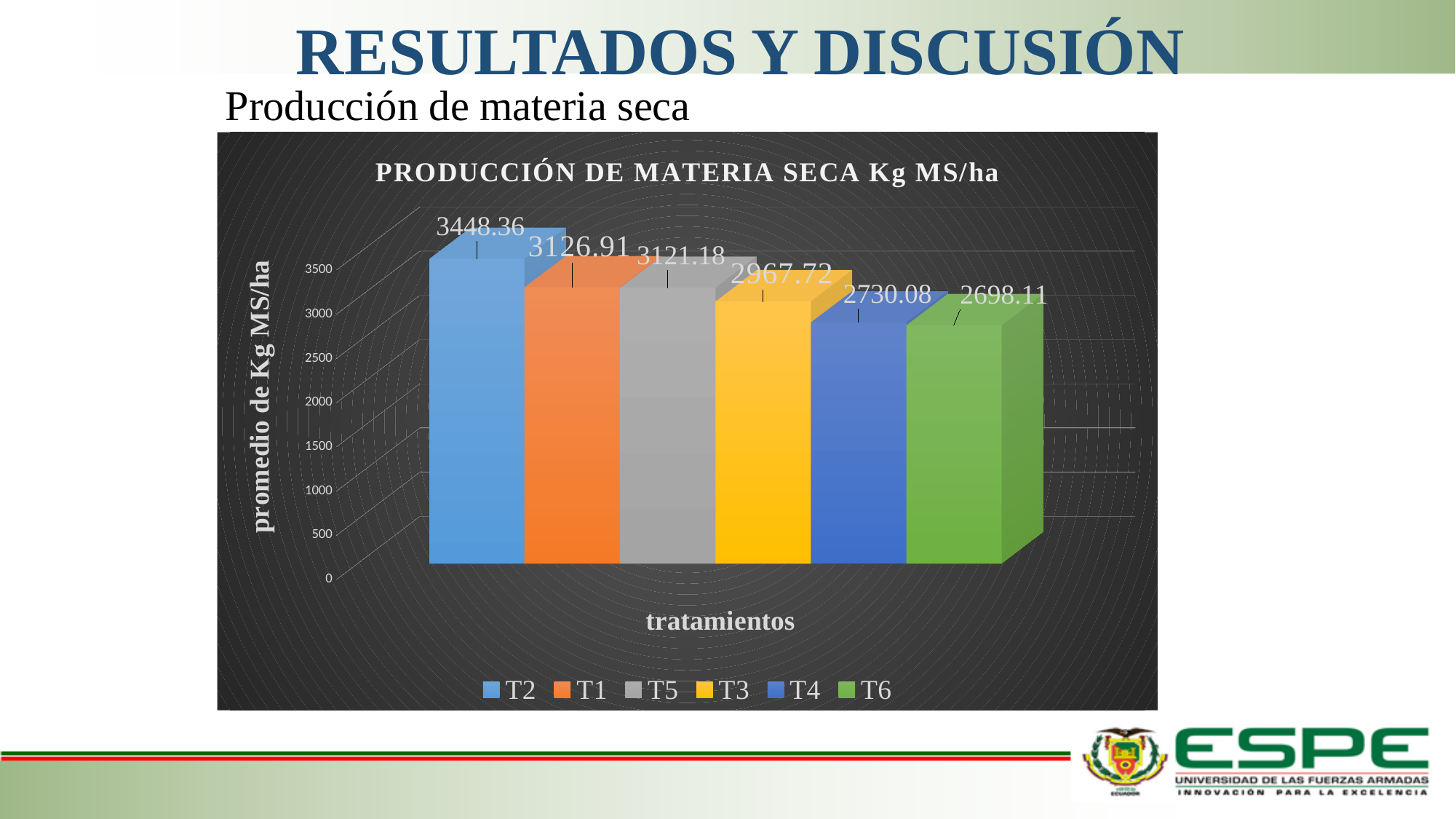
Which treatment has the highest production of dry matter? T2 What is the value for T4 in the chart? 2730.08 What type of chart is shown on the slide? bar chart How many bars are shown in the chart? 6 Which treatment has the lowest production of dry matter? T6 What is the difference between the values for T3 and T4? 237.64 What is the value for T3 in the chart? 2967.72 What is the difference between the values for T2 and T6? 750.25 Which is larger, the value for T2 or the value for T3? T2 Is the value for T4 greater or less than 3000? less What is the value for T2 in the chart? 3448.36 What is the value for T6 in the chart? 2698.11